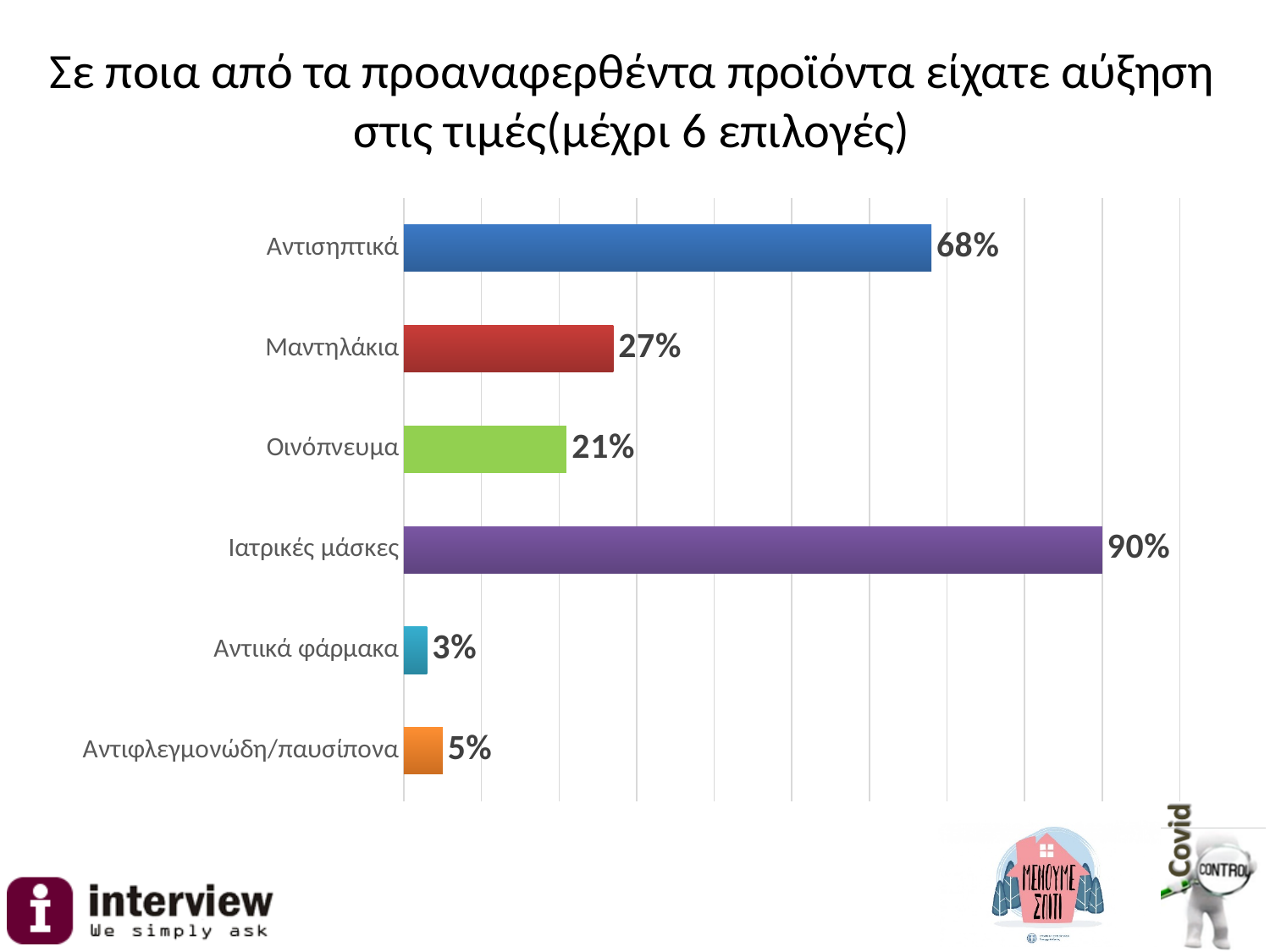
Which is larger, the value for Αντιφλεγμονώδη/παυσίπονα or the value for Αντιικά φάρμακα? Αντιφλεγμονώδη/παυσίπονα How many categories are shown in the chart? 6 Which category has the highest value? Ιατρικές μάσκες What is the value for Ιατρικές μάσκες? 90% What is the difference between the values for Ιατρικές μάσκες and Αντισηπτικά? 22% Which category has the lowest value? Αντιικά φάρμακα What is the value for Αντισηπτικά? 68% What colour is the bar for Ιατρικές μάσκες? Purple What is the value for Μαντηλάκια? 27% What is the difference between the values for Μαντηλάκια and Οινόπνευμα? 6% What kind of chart is shown on the slide? Bar chart What is the value for Αντιικά φάρμακα? 3%